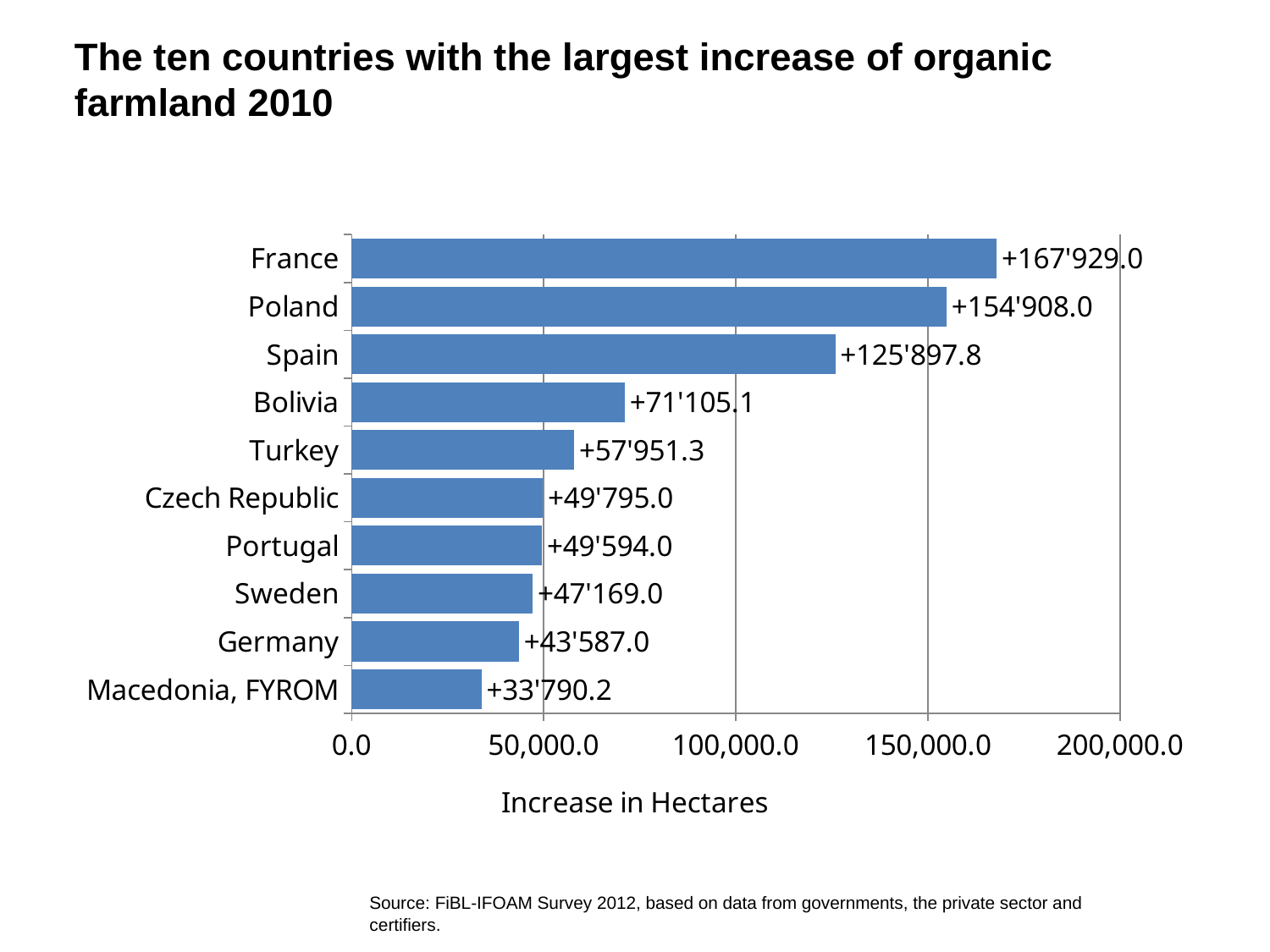
What is the label of the horizontal axis? Increase in Hectares Is the value for Germany greater or less than 50,000? less Which country has the largest increase of organic farmland in the chart? France What value is shown for Sweden? +47'169.0 Which country has the smallest increase shown in the chart? Macedonia, FYROM What is the increase in hectares shown for France? +167'929.0 How much larger is the increase for France than for Poland, in hectares? 13'021.0 What value is labelled on the bar for Spain? +125'897.8 How many countries are shown in the chart? 10 What is the increase in hectares shown for Macedonia, FYROM? +33'790.2 What kind of chart is shown on the slide? bar chart Which has the larger increase, Bolivia or Turkey? Bolivia